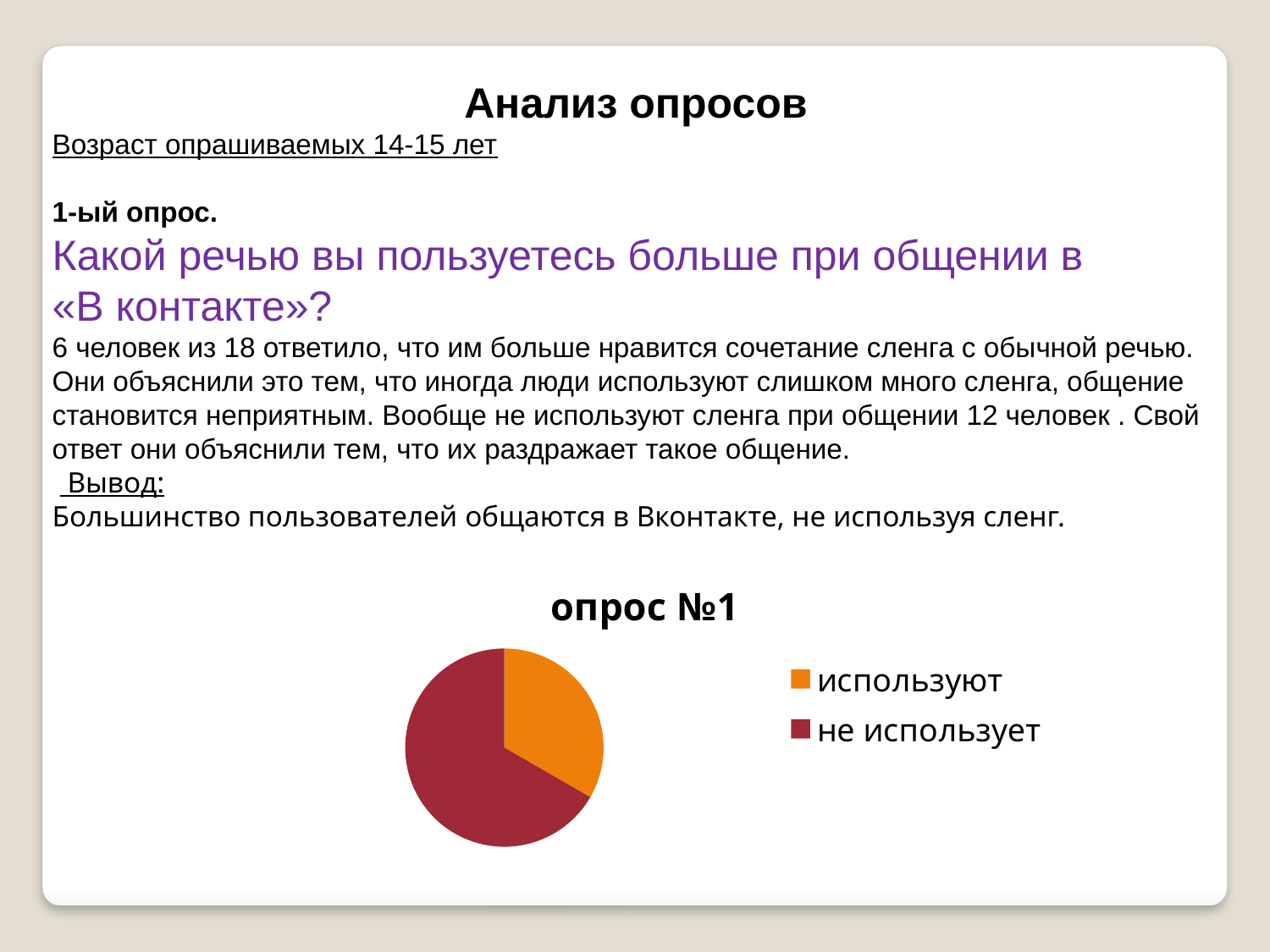
Which slice is larger, "используют" or "не использует"? не использует Does the "используют" slice take up more or less than half of the pie? less What colour is the "используют" slice in the pie chart? orange What is the title of the chart? опрос №1 Which slice of the pie chart is the smallest? используют How many slices does the pie chart have? 2 How many entries does the chart legend list? 2 Does the "не использует" slice take up more or less than half of the pie? more Which slice of the pie chart is the largest? не использует What kind of chart is shown on the slide? pie chart